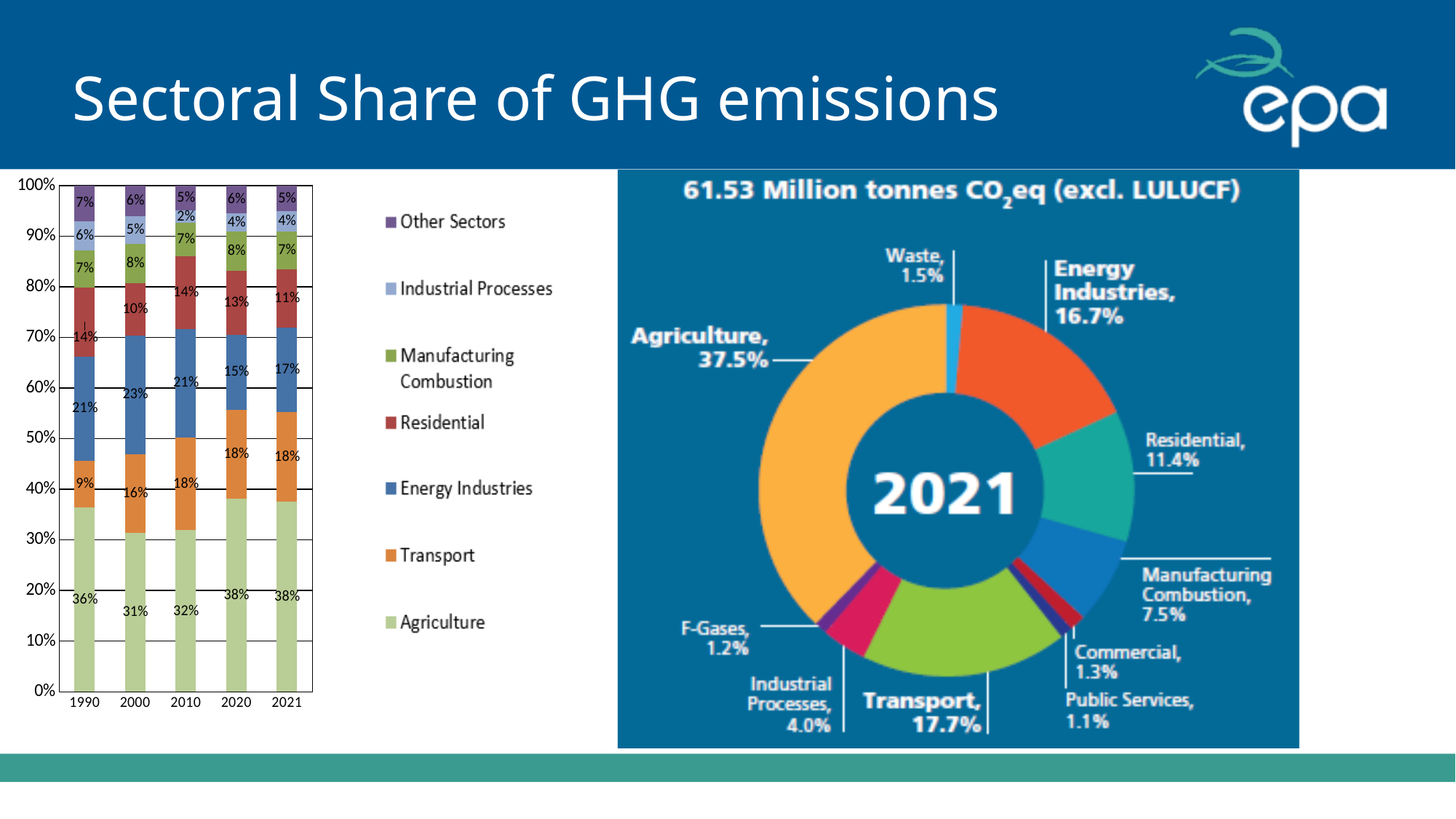
In the 2021 donut chart on the right, what total emissions figure is given in the title? 61.53 Million tonnes CO2eq (excl. LULUCF) In the stacked bar chart on the left, how many years are shown on the x axis? 5 In the 2021 donut chart on the right, which sector has the smallest share? Public Services In the stacked bar chart on the left, what is the Transport share in 2021? 18% In the stacked bar chart on the left, is the Energy Industries share larger in 1990 or in 2021? 1990 In the stacked bar chart on the left, how much did the Transport share change between 1990 and 2021? 9 percentage points In the stacked bar chart on the left, how many series does the legend list? 7 What kind of chart is shown on the left of the slide? Stacked bar chart In the stacked bar chart on the left, what is the Energy Industries share in 2000? 23% In the 2021 donut chart on the right, what share of emissions comes from Agriculture? 37.5% In the stacked bar chart on the left, what is the Agriculture share in 1990? 36% In the stacked bar chart on the left, which year has the lowest Agriculture share? 2000